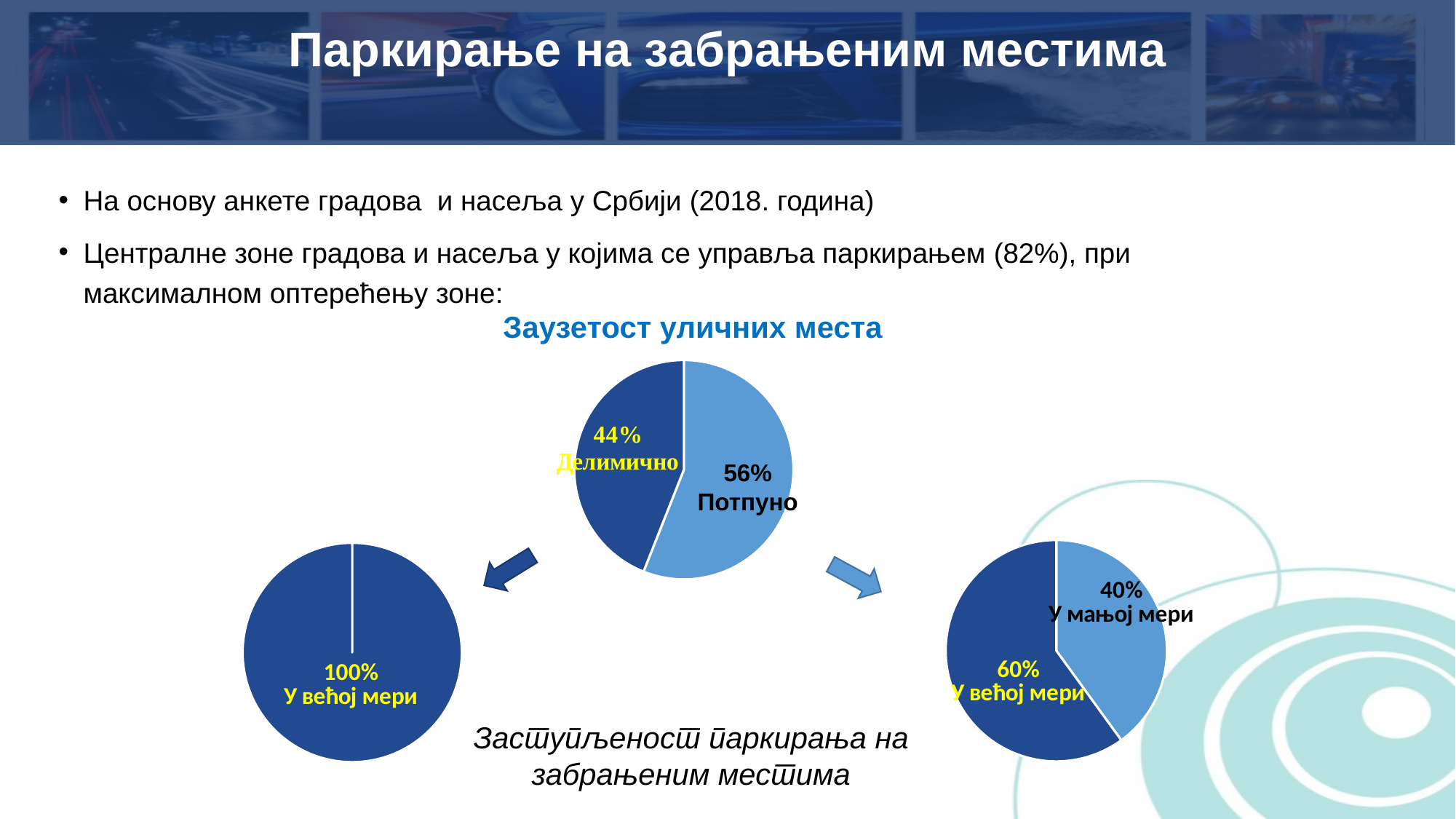
How many pie charts are shown on the slide? 3 In the bottom-right pie chart, what share is labelled 'У већој мери'? 60% In the bottom-right pie chart, which slice is the largest? У већој мери In the top chart titled 'Заузетост уличних места', how many slices does the pie have? 2 In the top chart titled 'Заузетост уличних места', which slice is larger, 'Потпуно' or 'Делимично'? Потпуно In the top chart titled 'Заузетост уличних места', what share is labelled 'Делимично'? 44% In the bottom-right pie chart, what is the difference between the 'У већој мери' and 'У мањој мери' shares? 20% In the bottom-left pie chart, what share is labelled 'У већој мери'? 100% What kind of chart is the top chart titled 'Заузетост уличних места'? Pie chart In the bottom-right pie chart, what share is labelled 'У мањој мери'? 40% In the top chart titled 'Заузетост уличних места', what is the difference between the 'Потпуно' and 'Делимично' shares? 12% In the top chart titled 'Заузетост уличних места', what share is labelled 'Потпуно'? 56%